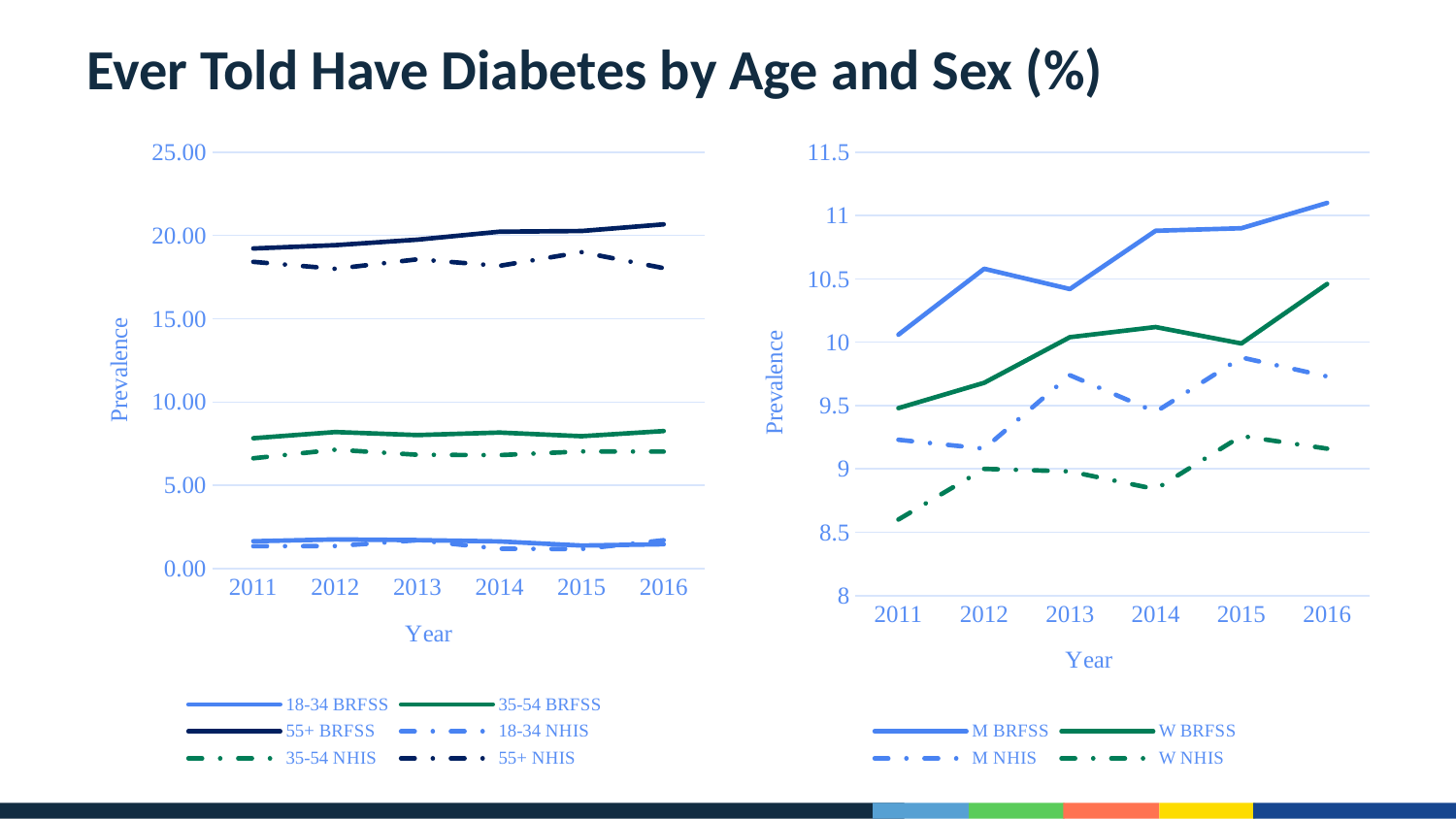
In the left chart, is the value for 18-34 BRFSS in 2013 greater or less than 5.00? less How many series does the legend of the right chart list? 4 How many years are plotted along the x axis of the left chart? 6 How many series does the legend of the left chart list? 6 What is the label on the y axis of the right chart? Prevalence In the left chart, does the 55+ BRFSS line rise or fall from 2011 to 2016? rise In the right chart, is the value for W NHIS in 2011 greater or less than 9? less What kind of chart is the left chart on the slide? line chart In the left chart, is the value for 55+ BRFSS in 2016 greater or less than 20.00? greater In the left chart, which series has the highest values across all years? 55+ BRFSS In the right chart, which is larger in 2016, M BRFSS or W BRFSS? M BRFSS In the right chart, which series has the lowest values across all years? W NHIS